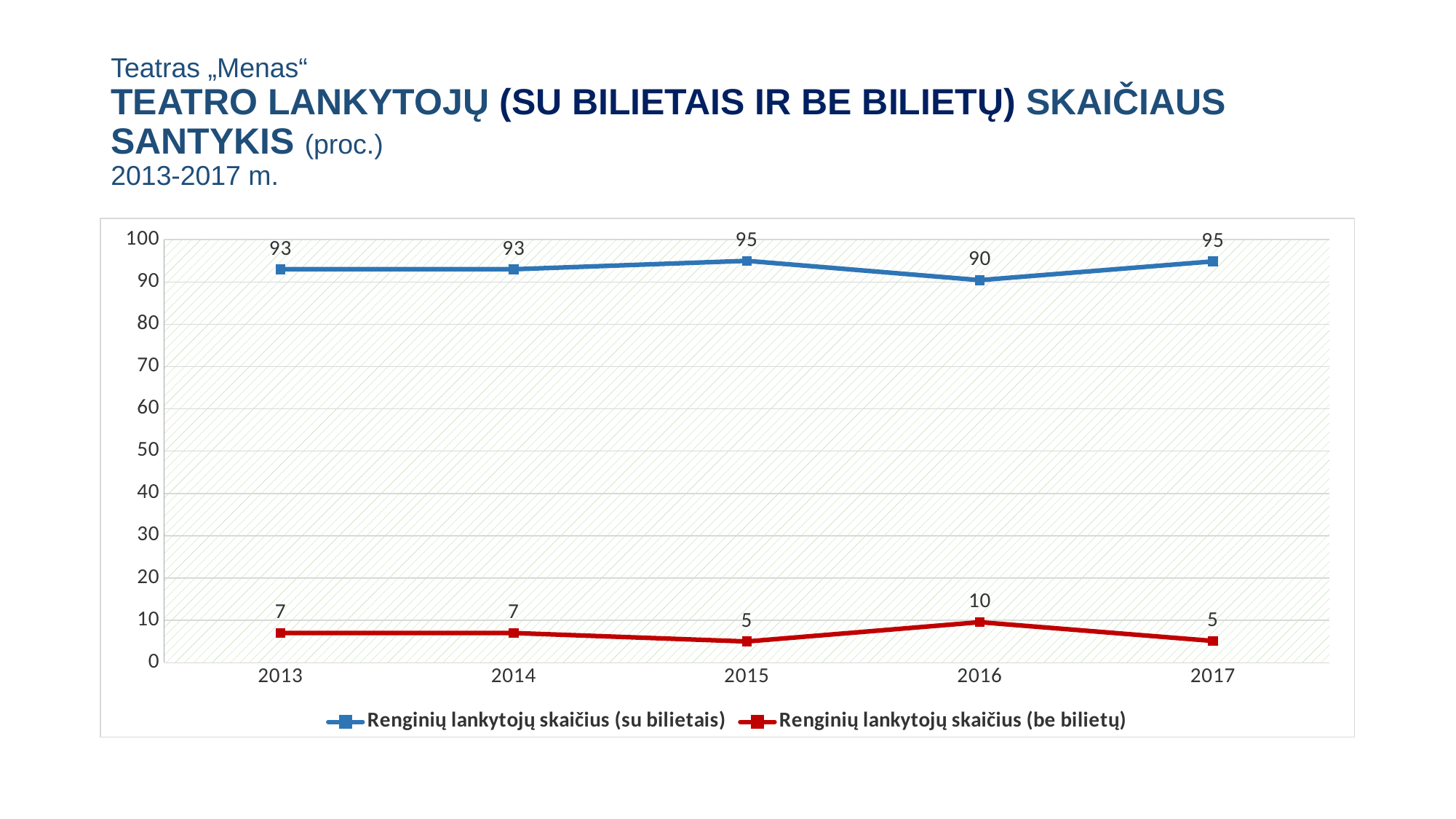
How many years are shown on the x axis? 5 Does the 'Renginių lankytojų skaičius (be bilietų)' series rise or fall from 2016 to 2017? fall What is the value for 'Renginių lankytojų skaičius (su bilietais)' in 2016? 90 What is the value for 'Renginių lankytojų skaičius (su bilietais)' in 2013? 93 In which year is 'Renginių lankytojų skaičius (su bilietais)' lowest? 2016 In which year is 'Renginių lankytojų skaičius (be bilietų)' highest? 2016 Is the value for 'Renginių lankytojų skaičius (be bilietų)' in 2016 greater or less than 20? less What type of chart is shown on the slide? line chart Which is larger in 2014: the 'su bilietais' value or the 'be bilietų' value? Renginių lankytojų skaičius (su bilietais) What is the value for 'Renginių lankytojų skaičius (be bilietų)' in 2016? 10 How many series does the legend list? 2 What is the difference between the 'su bilietais' and 'be bilietų' values in 2015? 90